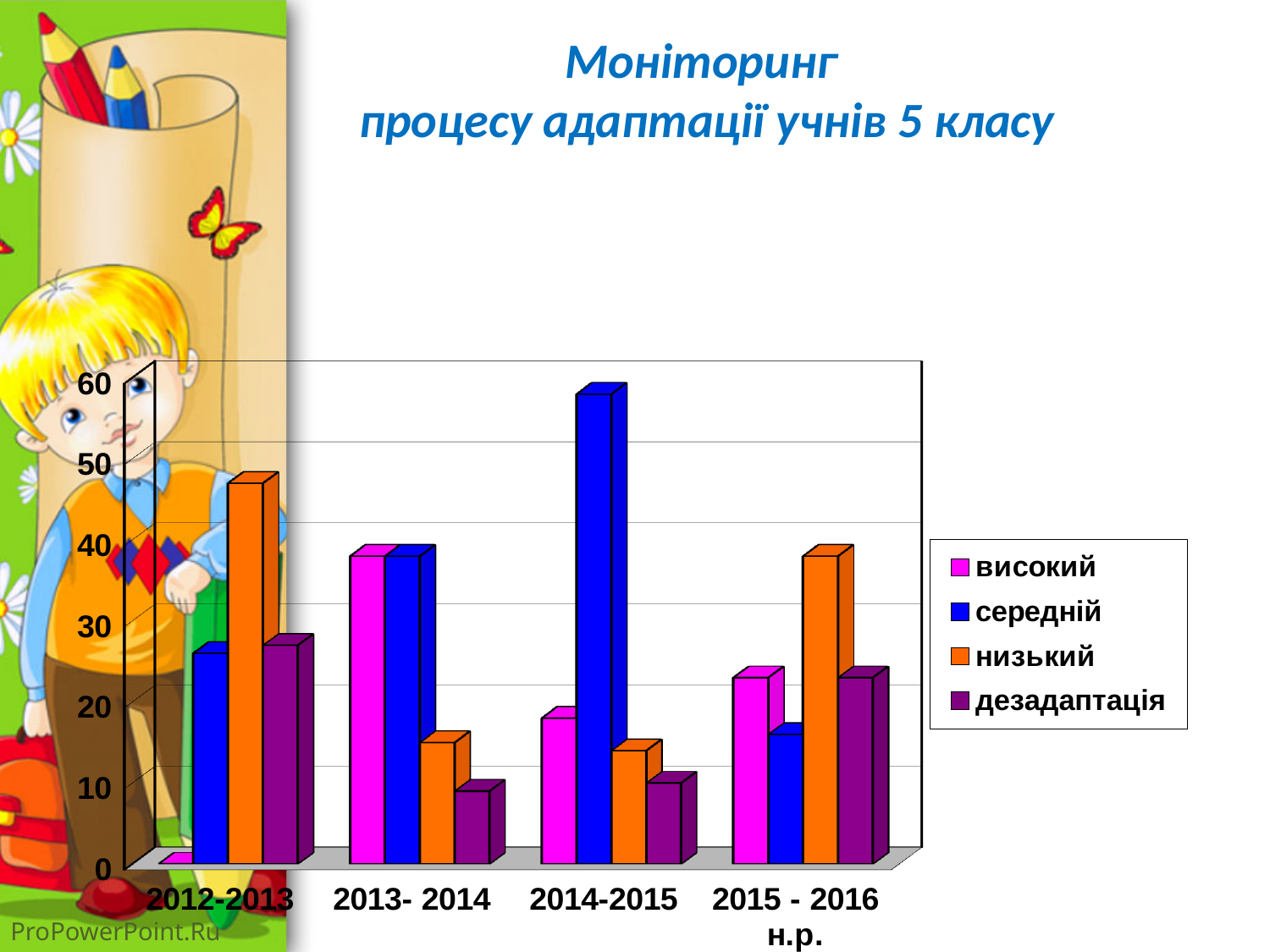
In which category is the середній bar the tallest? 2014-2015 In the 2015 - 2016 н.р. category, which is larger: низький or середній? низький Is the value for середній in 2015 - 2016 н.р. greater or less than 20? less How many school-year categories are shown on the x axis of the chart? 4 How many series does the chart legend list? 4 Is the value for дезадаптація in 2013- 2014 greater or less than 20? less What kind of chart is shown on the slide? bar chart Is the value for середній in 2014-2015 greater or less than 50? greater Which series has the shortest bar in the 2013- 2014 category? дезадаптація Which series has the tallest bar in the 2012-2013 category? низький Which colour represents the високий series in the chart legend? magenta (pink)